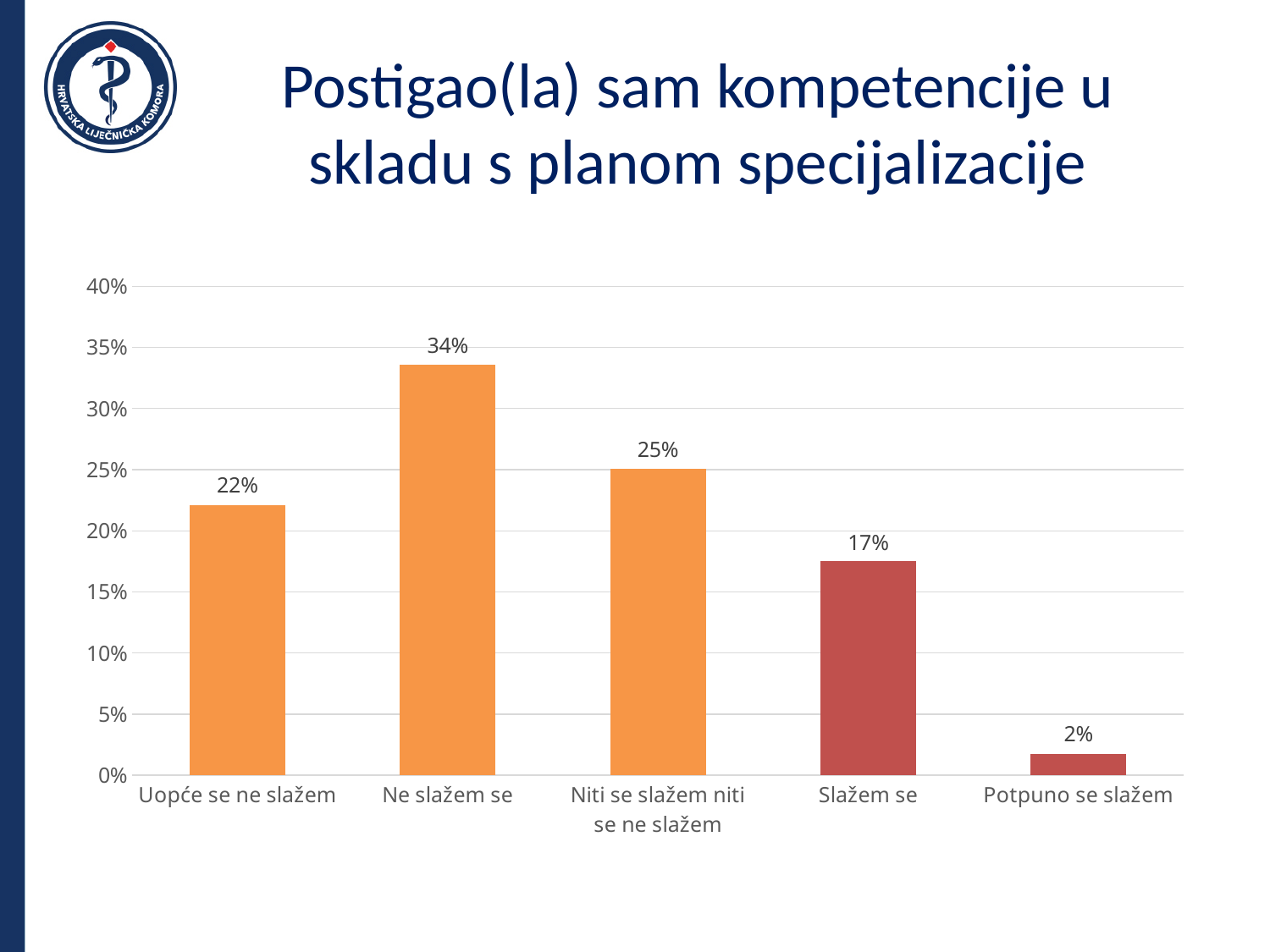
Which category has the highest value? Ne slažem se What is the value for "Slažem se"? 17% Which is larger, the value for "Uopće se ne slažem" or the value for "Slažem se"? Uopće se ne slažem What is the title of the slide? Postigao(la) sam kompetencije u skladu s planom specijalizacije What kind of chart is shown on the slide? bar chart How many categories are shown on the x axis? 5 Which category has the lowest value? Potpuno se slažem What is the difference between the values for "Ne slažem se" and "Niti se slažem niti se ne slažem"? 9% Is the value for "Niti se slažem niti se ne slažem" greater or less than 20%? greater What is the value for "Uopće se ne slažem"? 22% What is the value for "Ne slažem se"? 34% What is the value for "Potpuno se slažem"? 2%